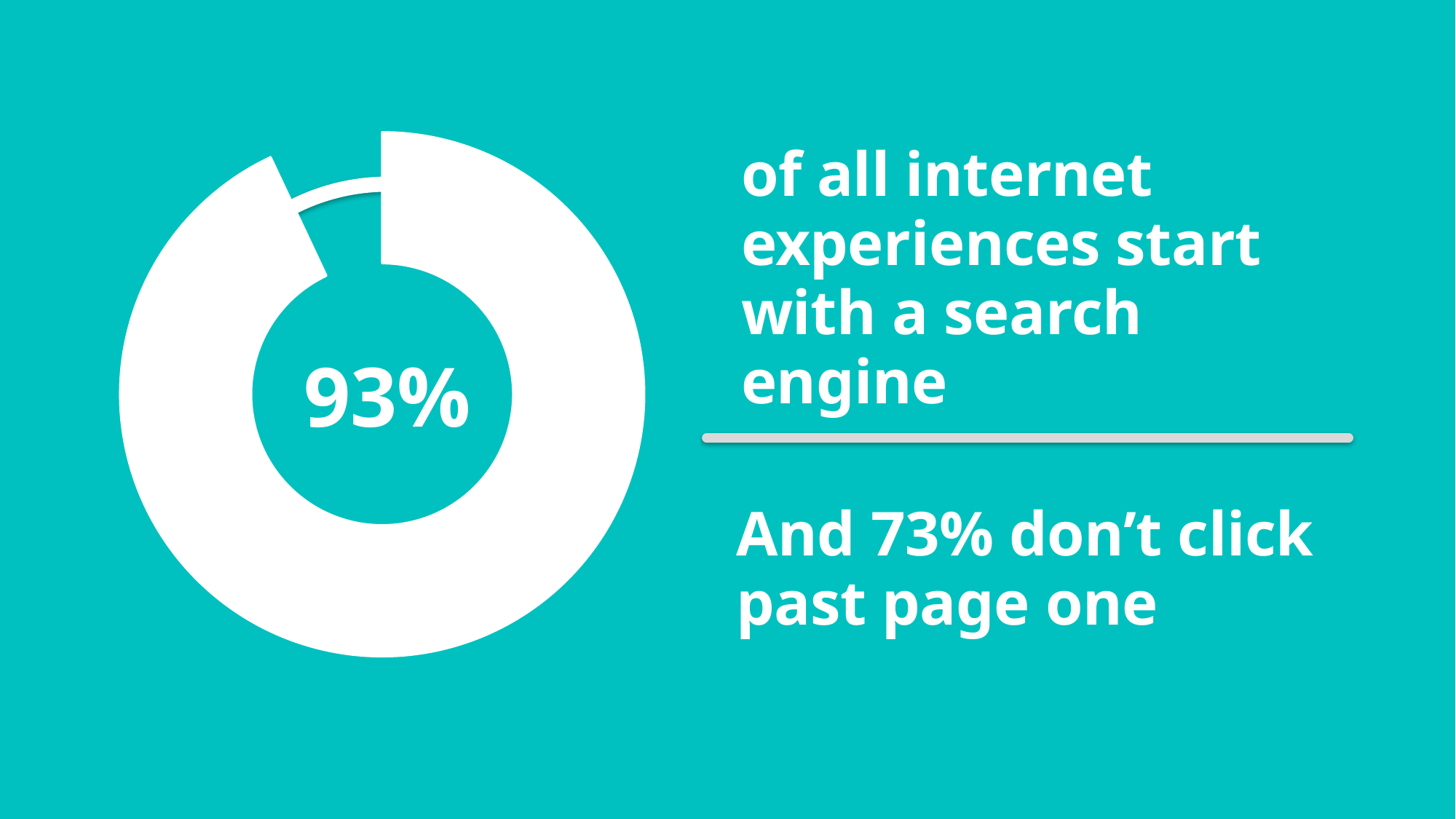
Which segment of the doughnut chart is larger, the solid white segment or the outlined segment? The solid white segment What share of the doughnut chart is filled in solid white? 93% How many segments does the doughnut chart have? 2 Is the filled portion of the doughnut chart greater or less than 50%? greater What colour is the filled segment of the doughnut chart? White What kind of chart is shown on the slide? Doughnut (pie) chart According to the slide, what does the 93% in the doughnut chart represent? Internet experiences that start with a search engine What percentage value is printed in the centre of the doughnut chart? 93%